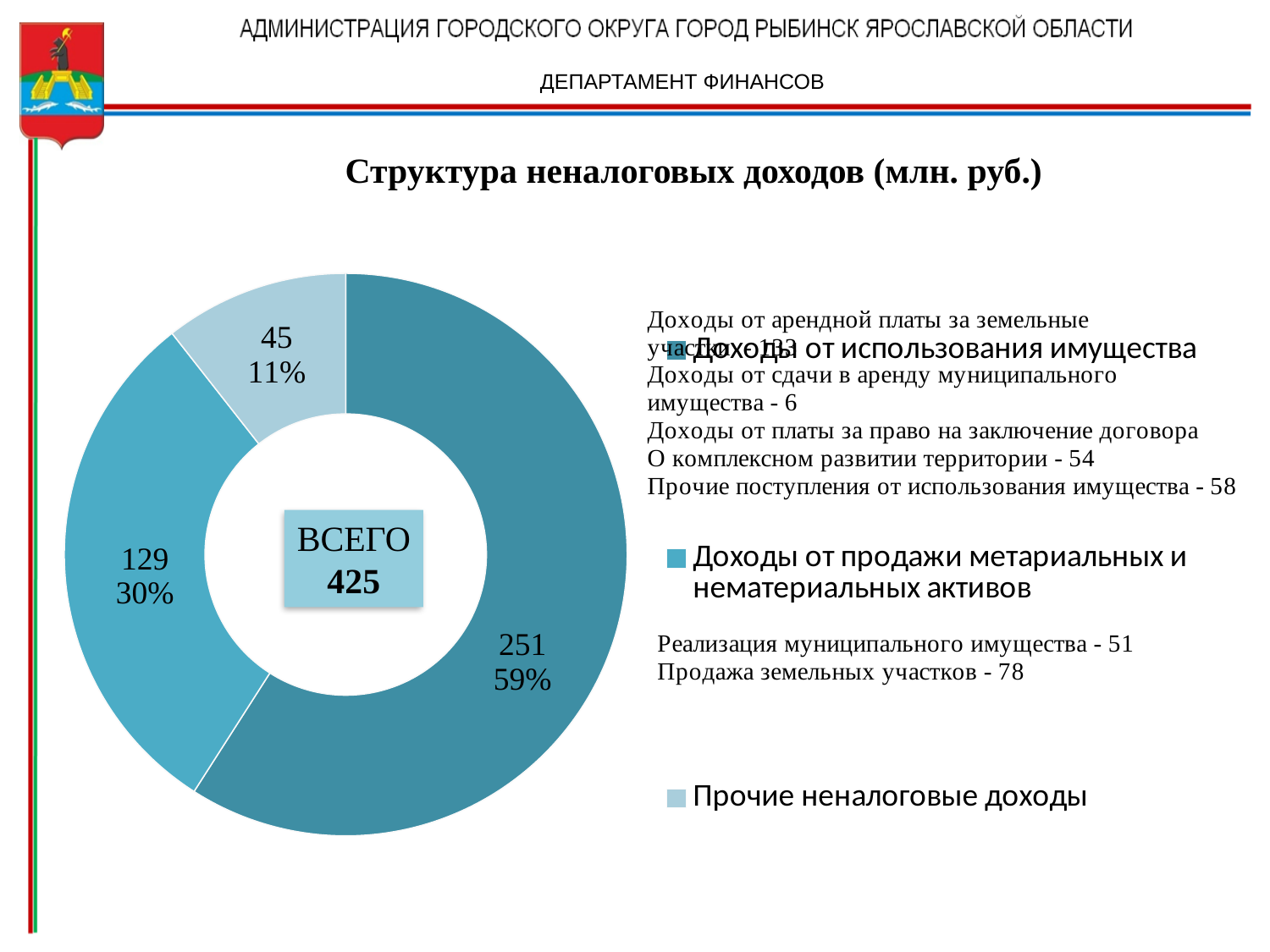
What is the value for Прочие неналоговые доходы? 45 What share of the total does Доходы от использования имущества represent? 59% What is the value for Доходы от продажи метариальных и нематериальных активов? 129 What is the value for Доходы от использования имущества? 251 What share of the total does Прочие неналоговые доходы represent? 11% What is the difference between the values for Доходы от использования имущества and Доходы от продажи метариальных и нематериальных активов? 122 Which category has the largest slice? Доходы от использования имущества How many entries does the legend list? 3 What kind of chart is shown on the slide? Doughnut (pie) chart How many slices does the doughnut chart have? 3 Which category has the smallest slice? Прочие неналоговые доходы What is the title of the chart? Структура неналоговых доходов (млн. руб.)